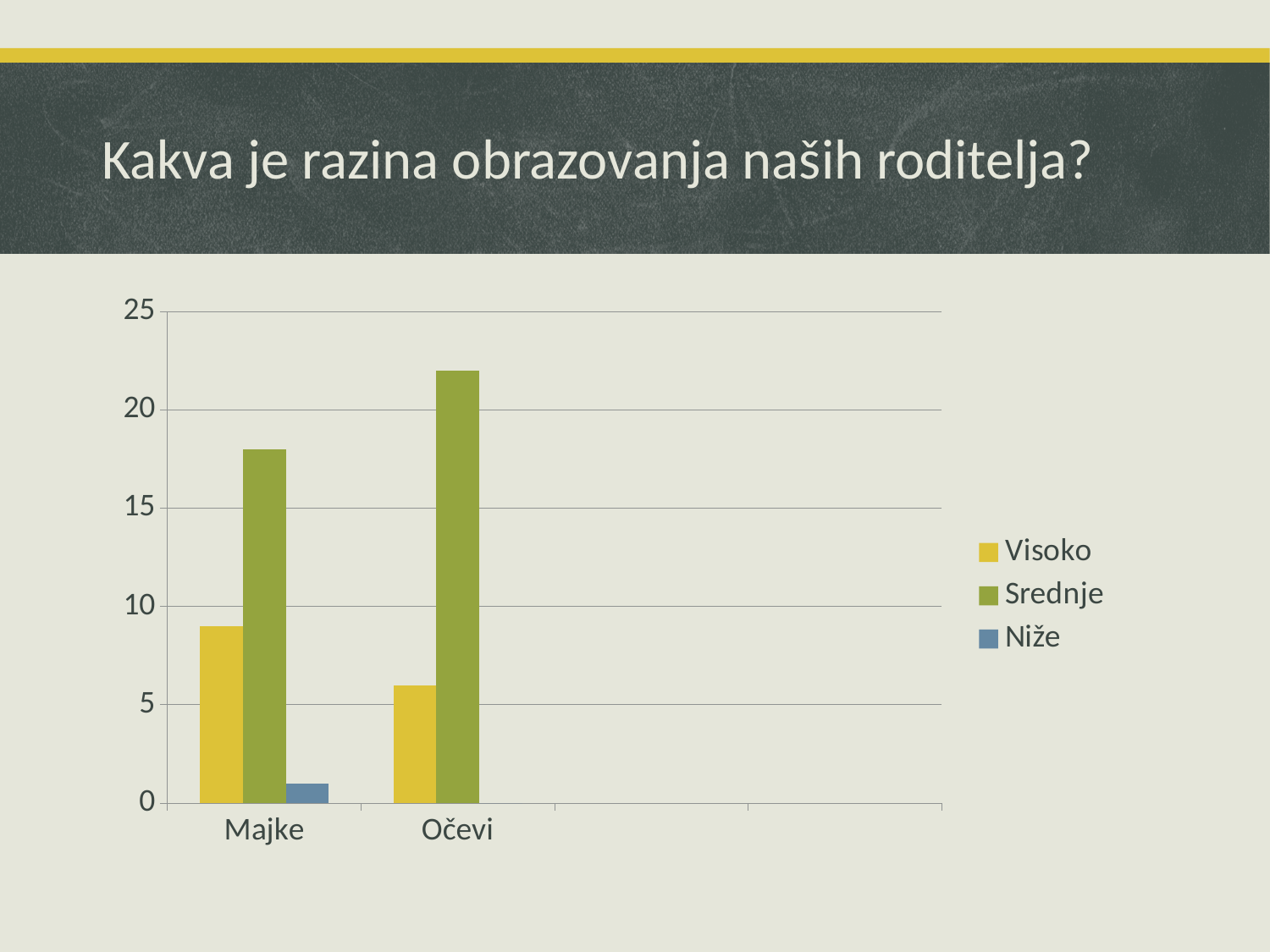
Which series has the highest value for Majke? Srednje Is the Srednje value for Majke greater or less than 15? greater Which category has the larger Visoko value, Majke or Očevi? Majke How many series does the legend list? 3 Which category has the larger Srednje value, Majke or Očevi? Očevi Which series has the lowest value for Majke? Niže Is the Visoko value for Majke greater or less than 10? less Which series has the highest value for Očevi? Srednje What is the title of the slide containing the chart? Kakva je razina obrazovanja naših roditelja? Is the Srednje value for Očevi greater or less than 20? greater How many categories are shown on the x axis? 2 What kind of chart is shown on the slide? bar chart